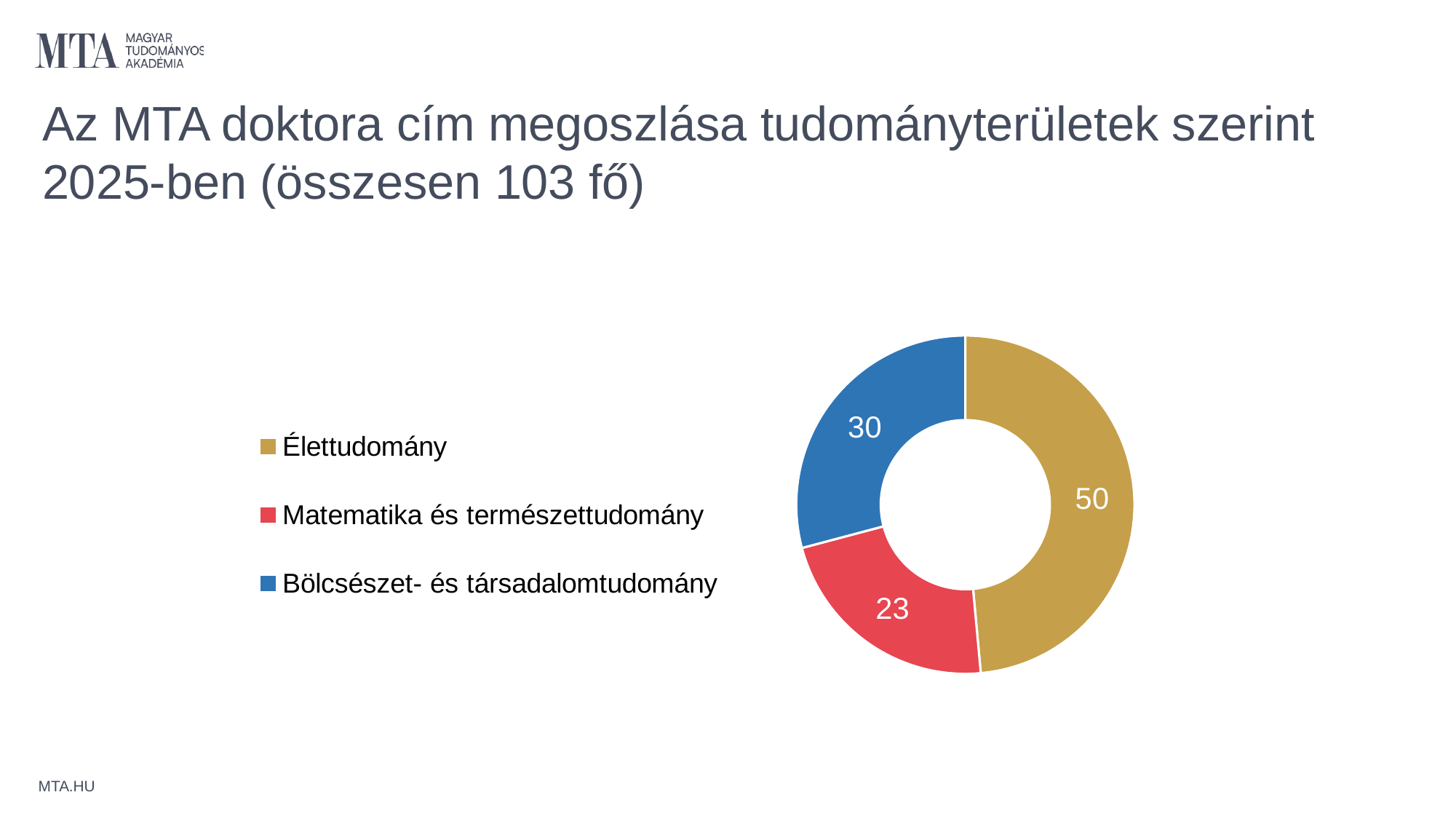
What is the value for Matematika és természettudomány? 23 What kind of chart is shown on the slide? Doughnut (pie) chart Which is larger, the value for Bölcsészet- és társadalomtudomány or the value for Matematika és természettudomány? Bölcsészet- és társadalomtudomány Which category has the lowest value? Matematika és természettudomány What is the total of all the slices in the chart? 103 Which category has the highest value? Élettudomány What is the difference between the values for Bölcsészet- és társadalomtudomány and Matematika és természettudomány? 7 What is the value for Élettudomány? 50 How many categories does the chart show? 3 What is the difference between the values for Élettudomány and Bölcsészet- és társadalomtudomány? 20 Which colour represents Matematika és természettudomány in the chart? Red What is the value for Bölcsészet- és társadalomtudomány? 30